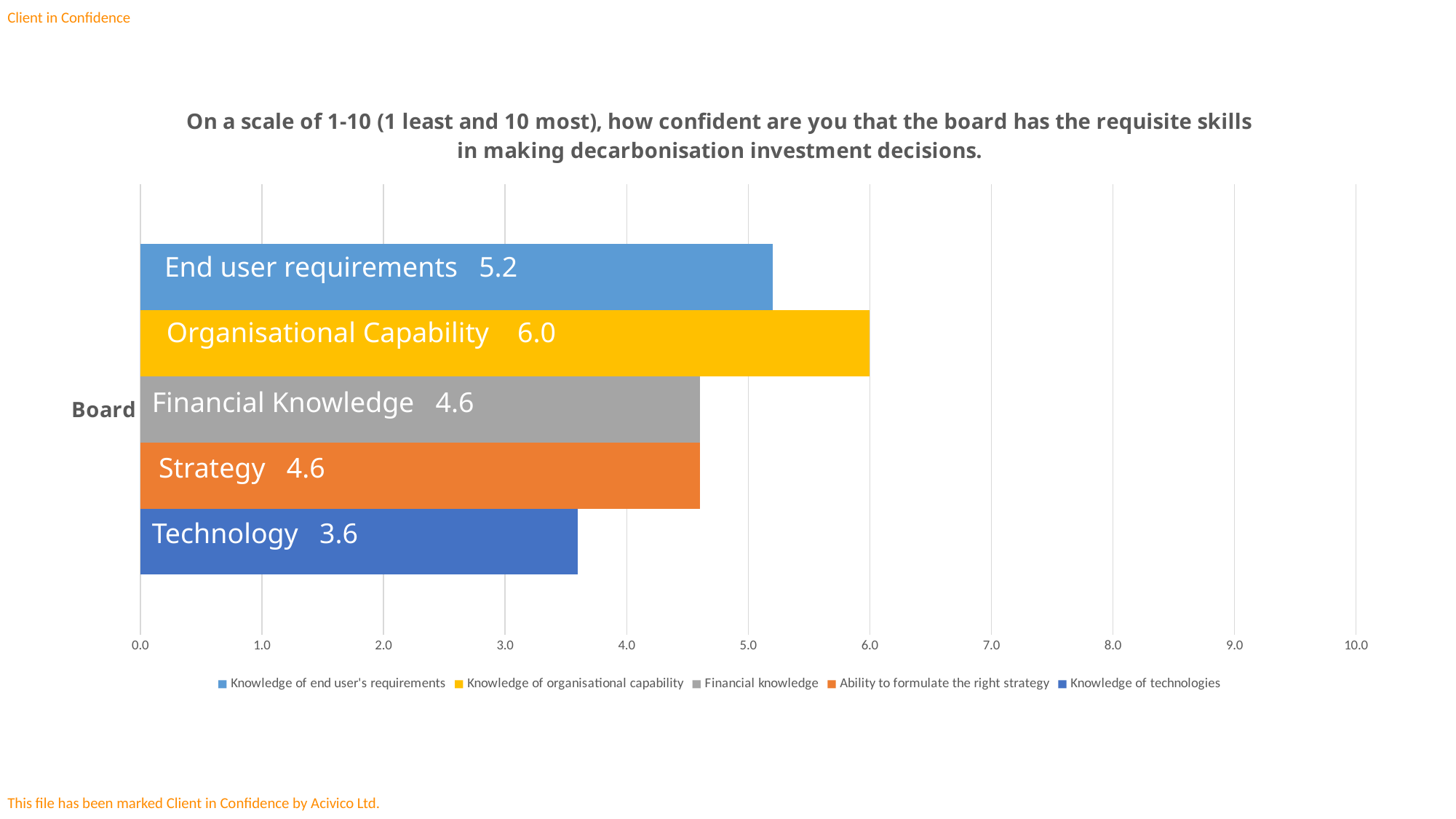
What is the value for Organisational Capability? 6.0 What is the category label shown on the vertical axis? Board How many series does the legend list? 5 Which skill area has the highest confidence score? Organisational Capability Which skill area has the lowest confidence score? Technology What kind of chart is shown on the slide? Bar chart What is the value for End user requirements? 5.2 Which is larger, the value for End user requirements or the value for Strategy? End user requirements What is the value for Technology? 3.6 What is the value for Financial Knowledge? 4.6 Is the value for End user requirements greater or less than 5.0? greater What is the difference between the values for Organisational Capability and Technology? 2.4